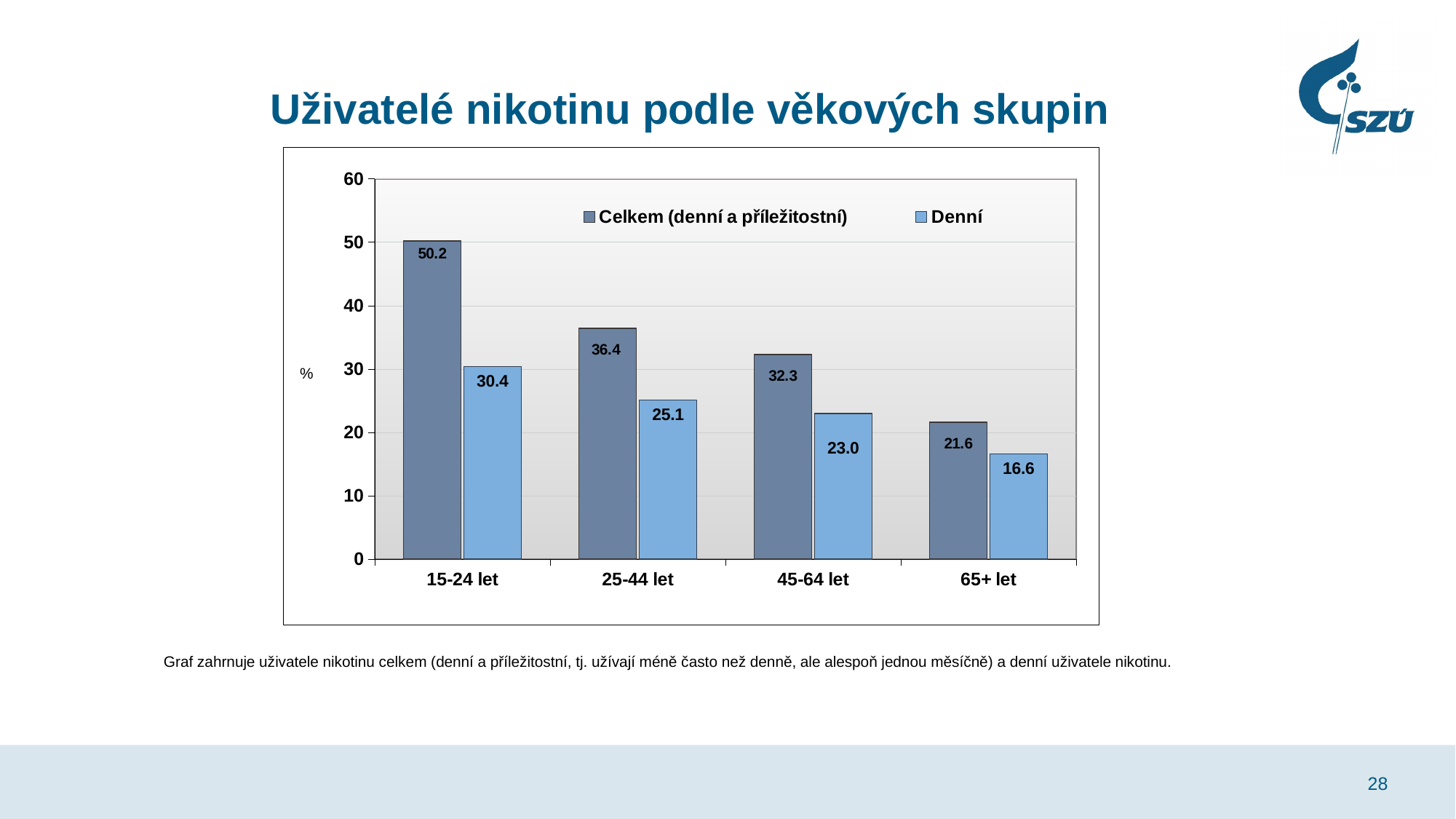
How many age groups are shown on the x axis? 4 How many series does the legend list? 2 Which age group has the lowest value for Denní? 65+ let What is the value for Celkem (denní a příležitostní) in the 15-24 let age group? 50.2 What is the difference between Celkem (denní a příležitostní) and Denní in the 45-64 let age group? 9.3 What is the value for Denní in the 65+ let age group? 16.6 Which age group has the highest value for Celkem (denní a příležitostní)? 15-24 let Is the value for Denní in the 15-24 let age group greater or less than 40? less Do the values for Celkem (denní a příležitostní) rise or fall from the youngest to the oldest age group? fall Which is larger: Celkem (denní a příležitostní) for 25-44 let or Celkem (denní a příležitostní) for 45-64 let? 25-44 let What kind of chart is shown on the slide? bar chart What is the value for Denní in the 25-44 let age group? 25.1